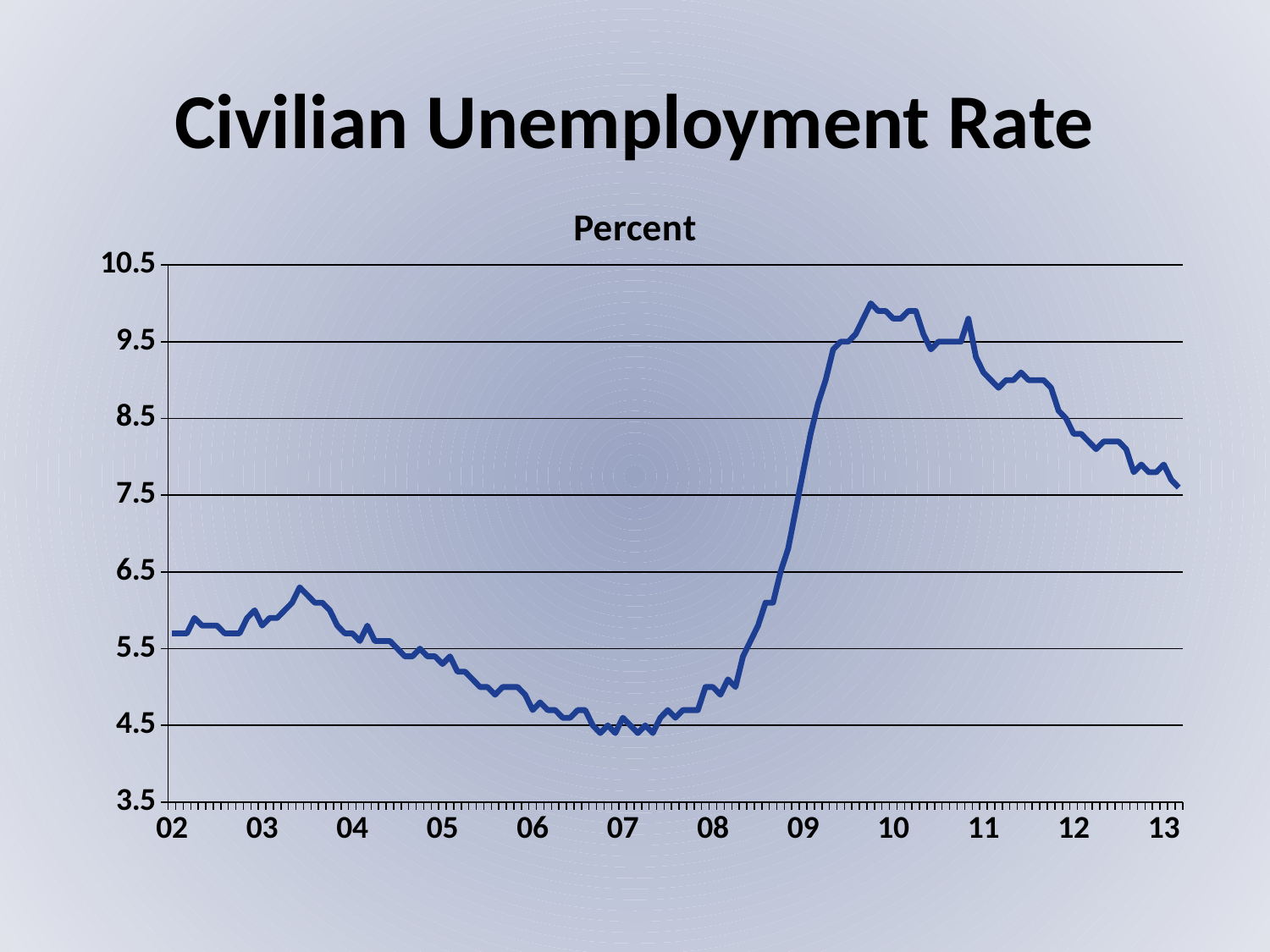
Does the unemployment rate rise or fall between the start of 2011 and the start of 2013? fall What is the title of the chart? Civilian Unemployment Rate What unit label is shown above the chart's vertical axis? Percent Is the unemployment rate at the start of 2010 greater or less than 9.5? greater How many year labels are shown along the x axis? 12 Is the unemployment rate higher at the start of 2010 or at the start of 2007? 2010 Is the unemployment rate at the start of 2007 greater or less than 5.5? less Does the unemployment rate rise or fall between the start of 2009 and the start of 2010? rise Is the unemployment rate at the start of 2008 greater or less than 5.5? less How many lines are plotted on the chart? 1 What kind of chart is shown on the slide? line chart